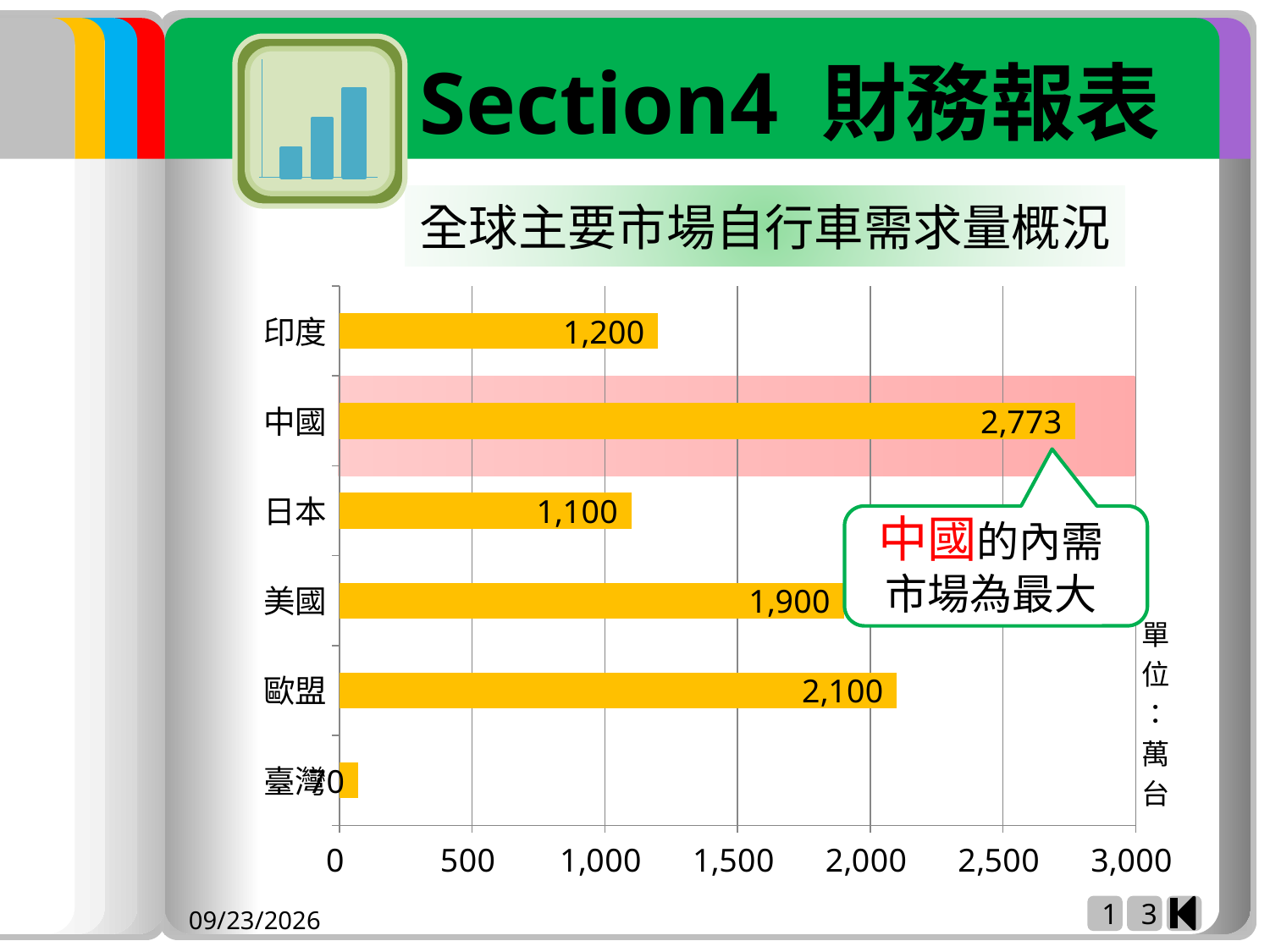
Is the value for 臺灣 greater or less than 500? less How many categories are shown in the chart? 6 What is the difference between the values for 印度 and 日本? 100 Which category has the highest value? 中國 What is the value for 美國? 1,900 What is the value for 日本? 1,100 What is the difference between the values for 歐盟 and 美國? 200 Which is larger, the value for 印度 or the value for 日本? 印度 What is the value for 歐盟? 2,100 What is the value for 中國? 2,773 Which category has the lowest value? 臺灣 What kind of chart is shown on the slide? bar chart